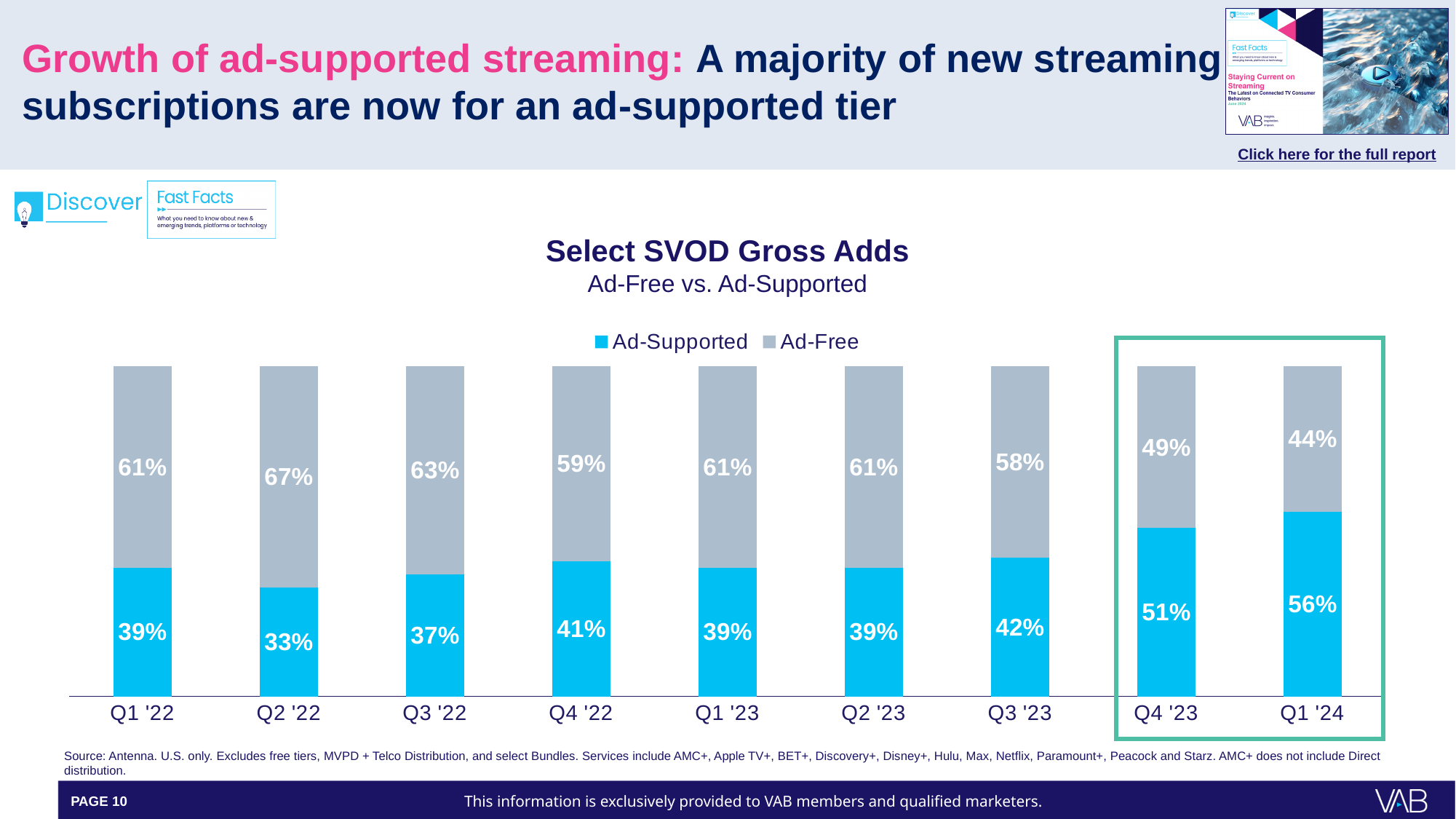
What is the title of the chart? Select SVOD Gross Adds What is the difference between the Ad-Supported share in Q1 '24 and in Q1 '22? 17% What is the Ad-Supported share for Q4 '23? 51% How many quarters are shown on the x axis? 9 Which quarter has the highest Ad-Supported share? Q1 '24 What kind of chart is shown? Stacked bar chart Which quarter has the lowest Ad-Supported share? Q2 '22 Which is larger in Q3 '23, the Ad-Supported share or the Ad-Free share? Ad-Free What is the Ad-Free share for Q2 '22? 67% What is the Ad-Supported share for Q1 '24? 56% Which quarter has the highest Ad-Free share? Q2 '22 How many series does the legend list? 2